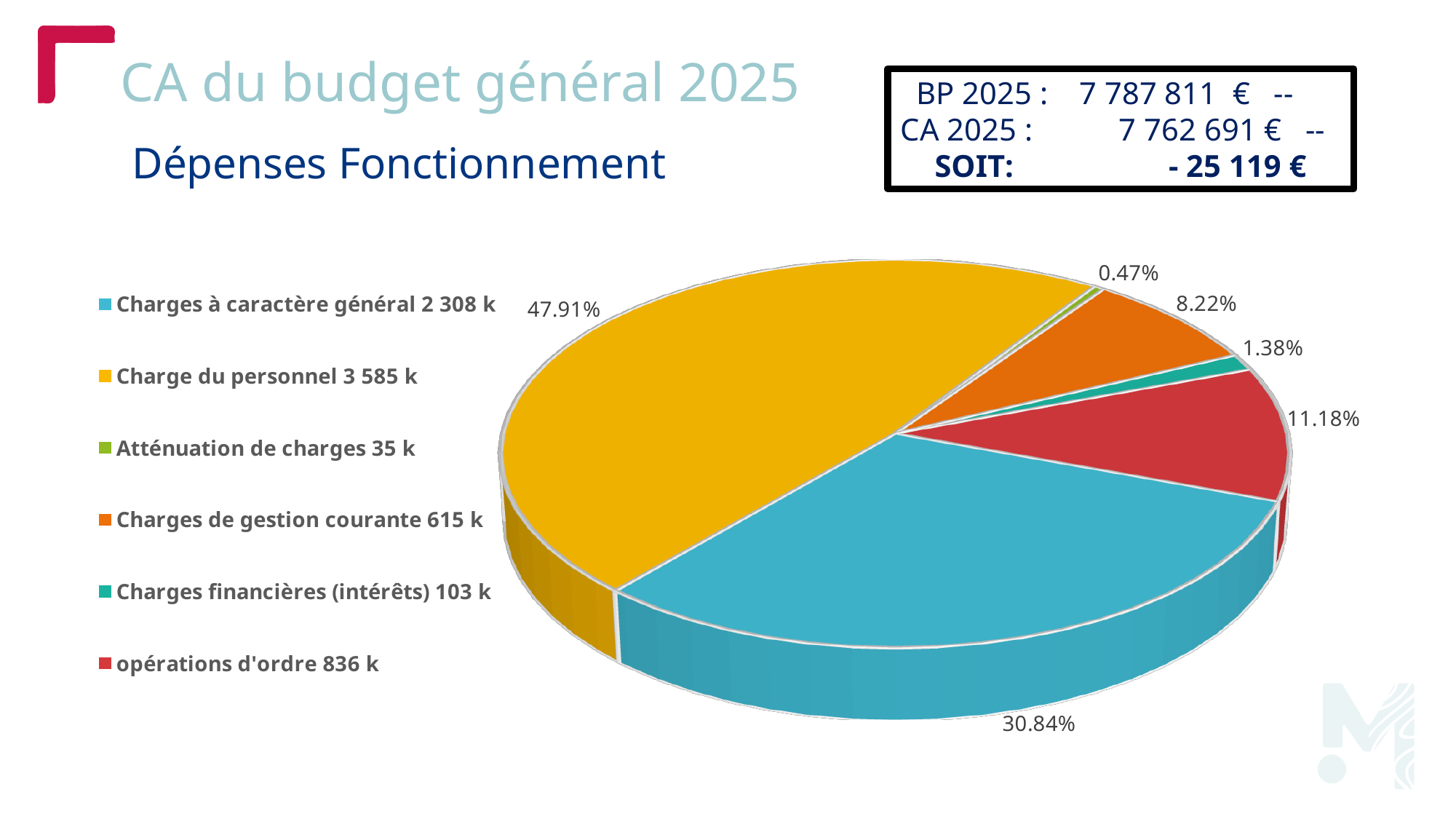
What kind of chart is shown on the slide? pie chart How many categories does the pie chart's legend list? 6 What share of the pie does Atténuation de charges represent? 0.47% What share of the pie does Charges de gestion courante represent? 8.22% What share of the pie does Charge du personnel represent? 47.91% What is the difference in percentage points between the Charge du personnel slice and the Charges à caractère général slice? 17.07 What value is shown in the legend for Charges financières (intérêts)? 103 k Which category has the smallest slice of the pie? Atténuation de charges Which category has the largest slice of the pie? Charge du personnel Which is larger, the share for Charges de gestion courante or the share for opérations d'ordre? opérations d'ordre